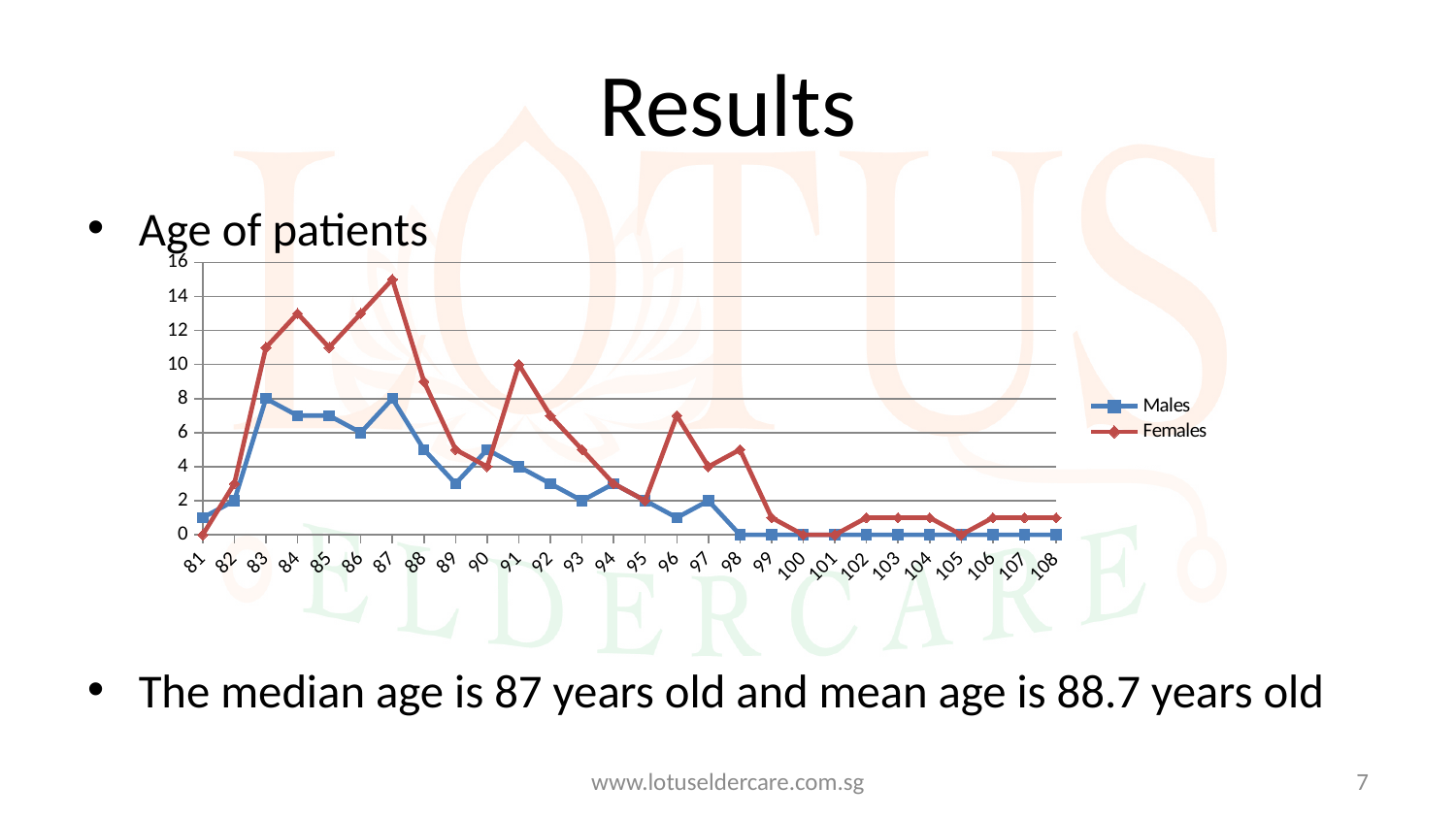
What is the value for Males at age 86? 6 Is the value for Males at age 84 greater or less than 8? less How many age categories are shown on the x axis? 28 What type of chart is shown on the slide? line chart What is the value for Males at age 83? 8 Is the value for Females at age 87 greater or less than 14? greater What is the value for Females at age 91? 10 At age 91, which series has the larger value, Males or Females? Females What is the difference between the Females and Males values at age 91? 6 How many series does the legend list? 2 At which age does the Females series reach its highest value? 87 What are the two series named in the legend? Males and Females